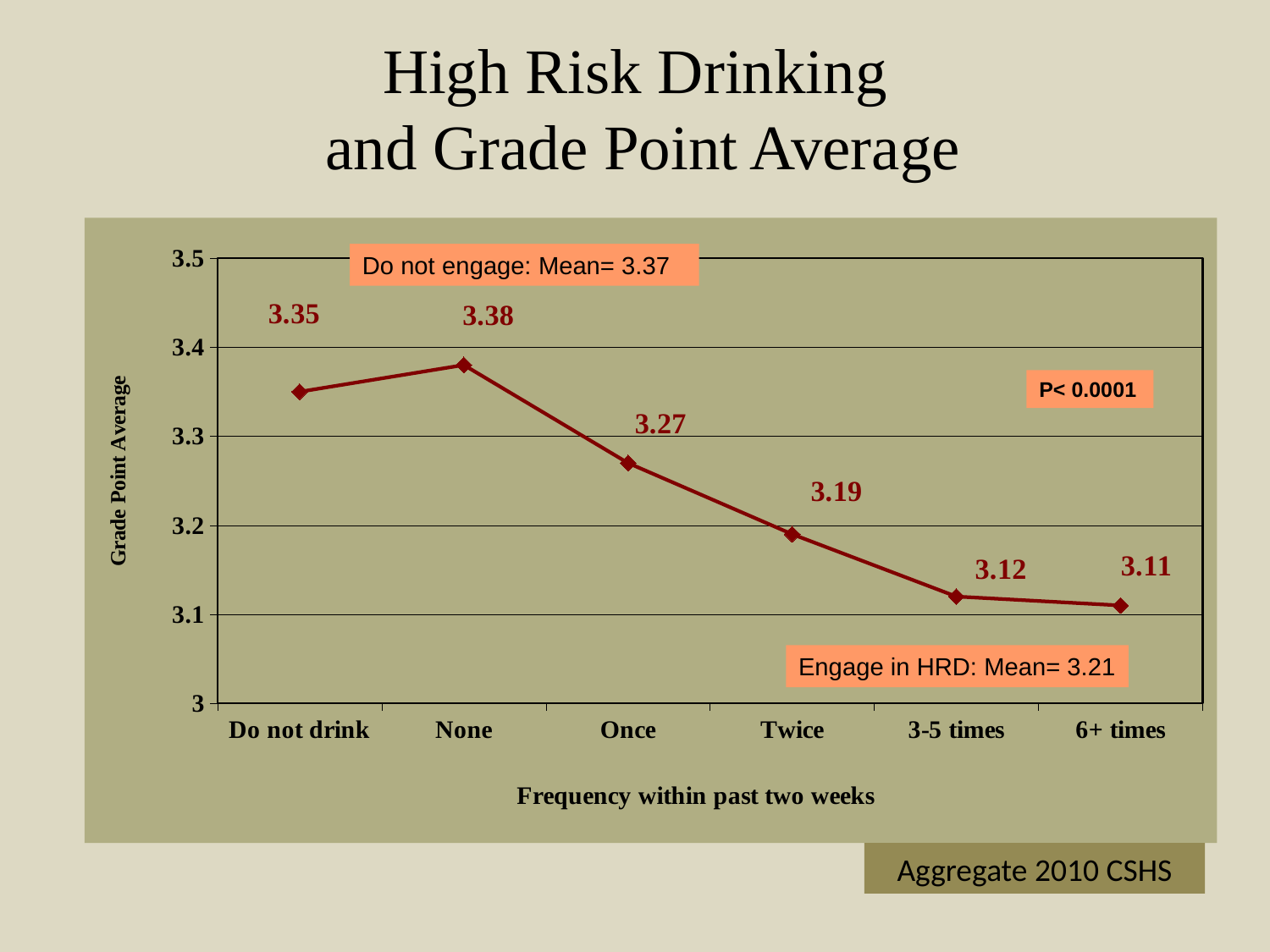
Which category has the highest Grade Point Average? None What kind of chart is shown on the slide? Line chart Which category has the lowest Grade Point Average? 6+ times What is the Grade Point Average for the 'Do not drink' category? 3.35 What is the label of the x axis? Frequency within past two weeks Do the values rise or fall from 'None' to '6+ times'? Fall Which has a higher Grade Point Average, 'Once' or '3-5 times'? Once How many categories are shown on the x axis? 6 What is the Grade Point Average for the '6+ times' category? 3.11 What is the Grade Point Average for the 'Once' category? 3.27 What is the difference in Grade Point Average between 'None' and 'Twice'? 0.19 Is the value for 'Twice' greater or less than 3.2? less